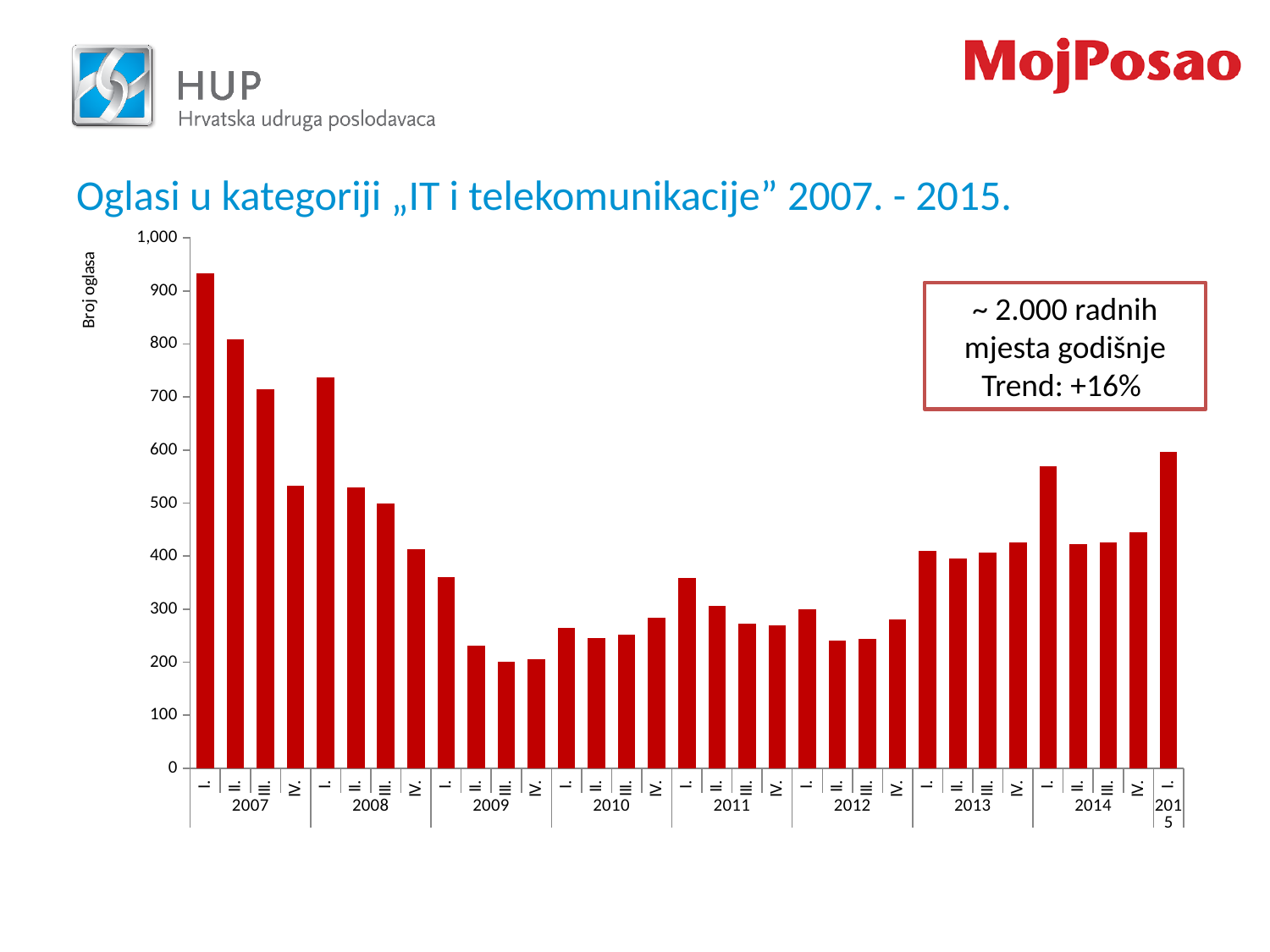
How many bars are plotted in the chart? 33 What is the title of the chart? Oglasi u kategoriji „IT i telekomunikacije” 2007. - 2015. Is the value for I. 2014 greater or less than 500? greater What kind of chart is shown on the slide? bar chart Is the value for I. 2007 greater or less than 900? greater Which is larger, the value for I. 2008 or the value for I. 2009? I. 2008 What is the label on the vertical axis of the chart? Broj oglasa Is the value for II. 2012 greater or less than 300? less In which year does the lowest bar of the chart occur? 2009 Which quarter has the highest bar in the chart? I. 2007 Do the values rise or fall from I. 2007 to IV. 2007? fall